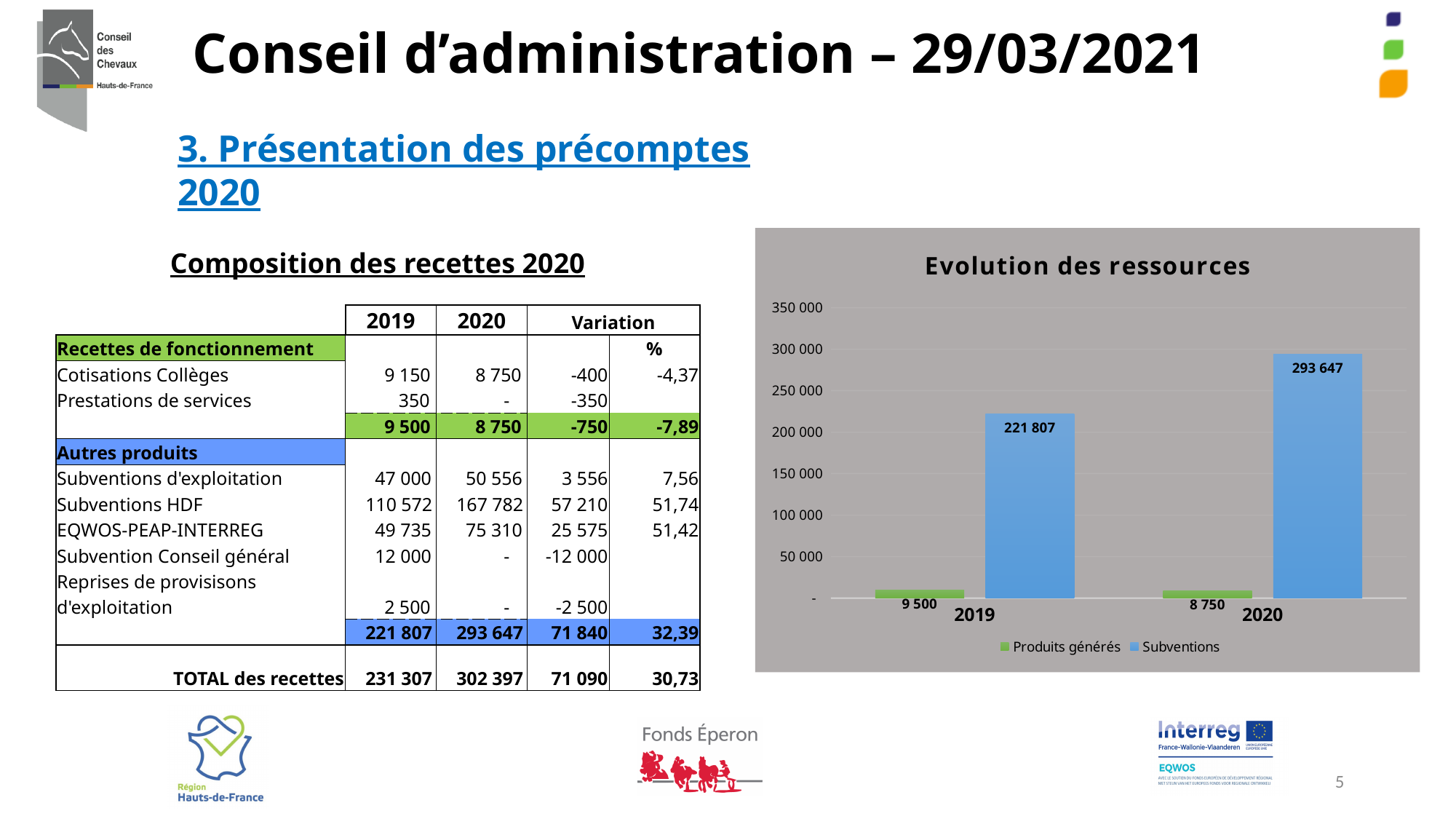
How many series does the chart legend list? 2 Do the Produits générés values rise or fall from 2019 to 2020? fall What is the value of Subventions for 2019 in the chart? 221 807 What type of chart is shown on the slide? bar chart What is the difference between Subventions in 2020 and Subventions in 2019? 71 840 Is the Subventions value for 2019 greater or less than 250 000? less What is the value of Produits générés for 2019 in the chart? 9 500 What is the title of the chart on the slide? Evolution des ressources How many years are shown on the x axis of the chart? 2 What is the value of Produits générés for 2020 in the chart? 8 750 In which year is the Subventions bar highest? 2020 What is the value of Subventions for 2020 in the chart? 293 647